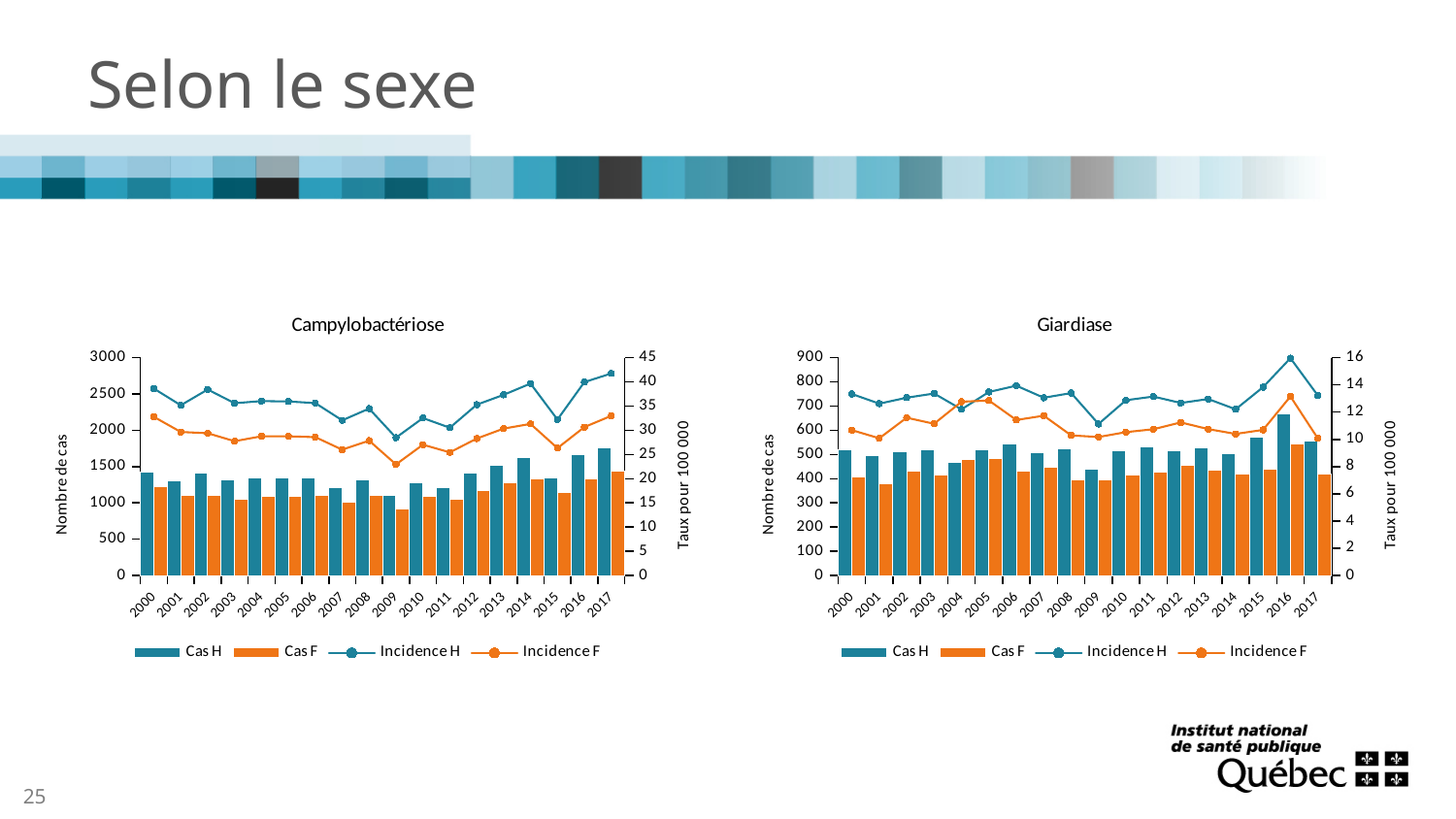
On the Giardiase chart, which is larger in 2000, Cas H or Cas F? Cas H On the Giardiase chart, does the Cas H series rise or fall from 2014 to 2016? rise What is the label of the right-hand vertical axis on the Giardiase chart? Taux pour 100 000 On the Giardiase chart, is the Cas H value for 2016 greater or less than 600? greater On the Giardiase chart, how many years are shown on the x axis? 18 On the Campylobactériose chart, in which year is the Incidence H line lowest? 2009 On the Campylobactériose chart, is the Cas H value for 2017 greater or less than 1500? greater On the Campylobactériose chart, in which year is the Cas H bar highest? 2017 On the Campylobactériose chart, is the Cas F value for 2009 greater or less than 1000? less On the Campylobactériose chart, how many series does the legend list? 4 On the Giardiase chart, in which year is the Incidence H line highest? 2016 What kind of chart is the Campylobactériose chart? Combined bar and line chart